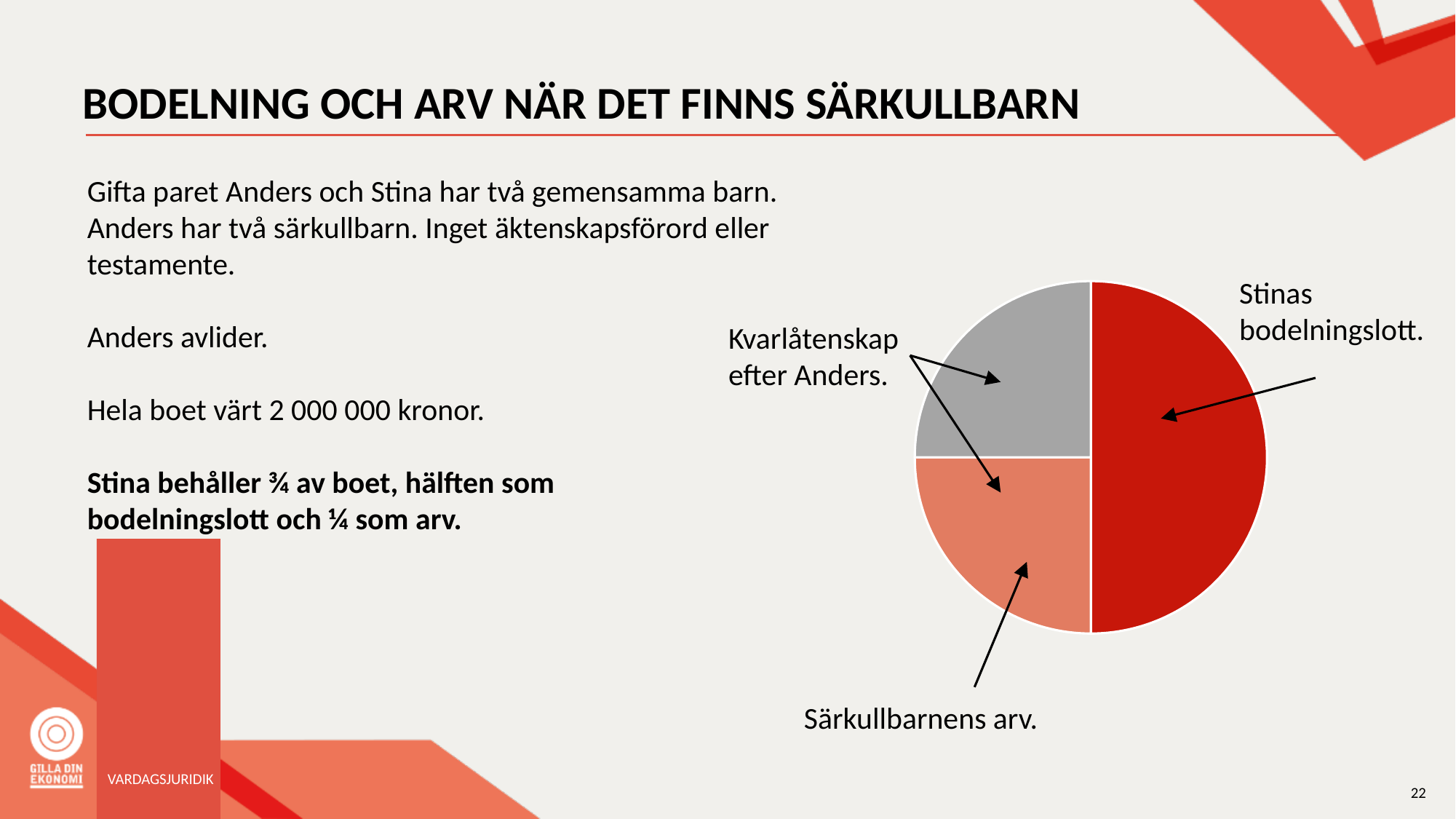
What kind of chart is shown on the slide? pie chart What share of the pie does Stinas bodelningslott take up? hälften (half) Which is larger in the pie chart, Stinas bodelningslott or Kvarlåtenskap efter Anders? Stinas bodelningslott What colour is the slice labelled Stinas bodelningslott? red How many slices does the pie chart have? 3 Which is larger in the pie chart, Stinas bodelningslott or Särkullbarnens arv? Stinas bodelningslott What colour is the slice labelled Kvarlåtenskap efter Anders? grey Which slice of the pie chart is the largest? Stinas bodelningslott